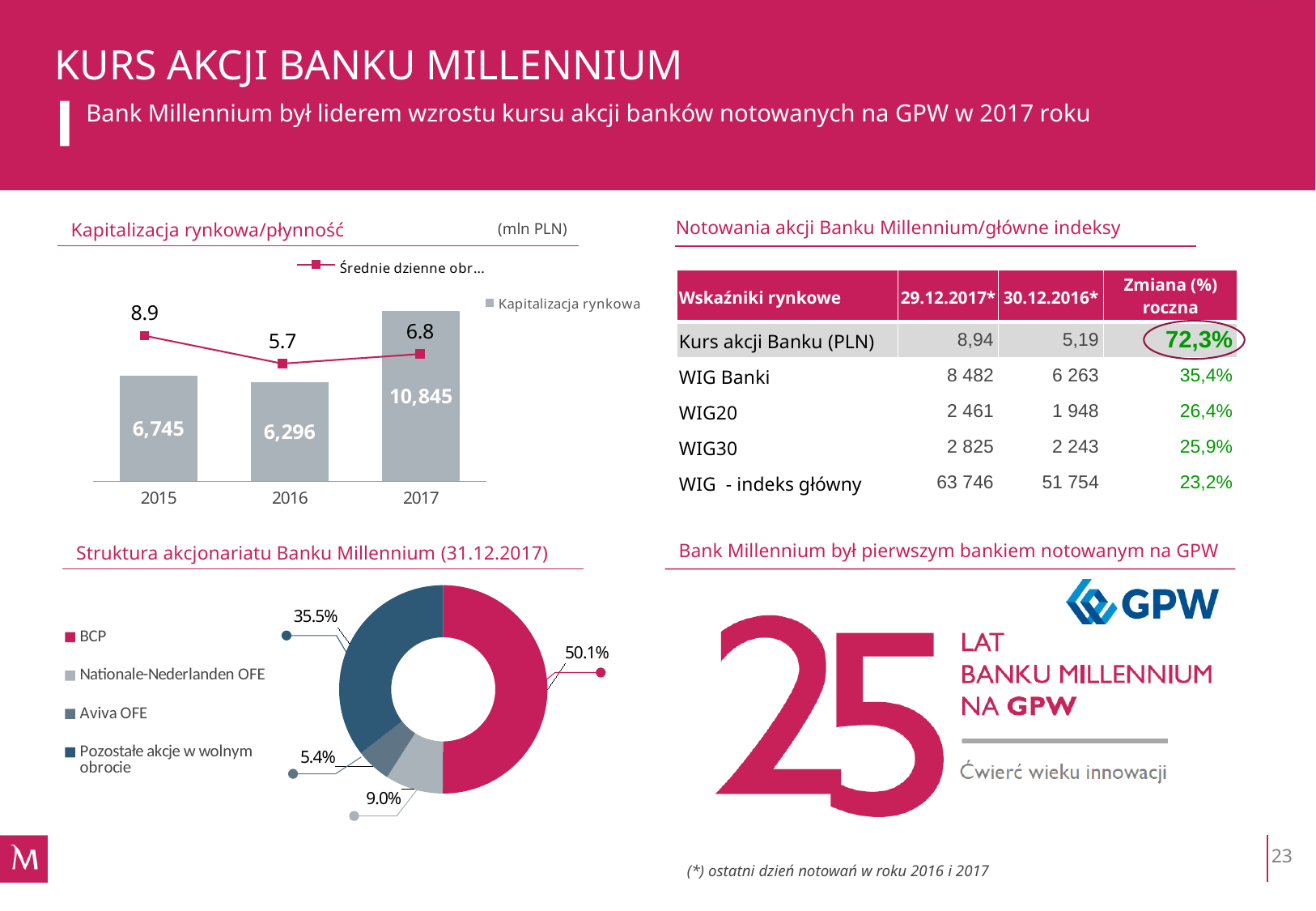
In the 'Kapitalizacja rynkowa/płynność' chart, what is the difference between the market capitalisation bars for 2017 and 2016? 4,549 In the 'Kapitalizacja rynkowa/płynność' chart, how many series does the legend list? 2 In the 'Kapitalizacja rynkowa/płynność' chart, what is the market capitalisation (Kapitalizacja rynkowa) value for 2017? 10,845 In the 'Struktura akcjonariatu Banku Millennium (31.12.2017)' chart, what share is held by Aviva OFE? 5.4% What type of chart is 'Struktura akcjonariatu Banku Millennium (31.12.2017)'? Donut (pie) chart In the 'Kapitalizacja rynkowa/płynność' chart, which year has the lowest value on the line series? 2016 In the 'Struktura akcjonariatu Banku Millennium (31.12.2017)' chart, which is larger: the share of Nationale-Nederlanden OFE or the share of Aviva OFE? Nationale-Nederlanden OFE In the 'Kapitalizacja rynkowa/płynność' chart, what is the market capitalisation value for 2016? 6,296 In the 'Kapitalizacja rynkowa/płynność' chart, which year has the highest market capitalisation bar? 2017 In the 'Struktura akcjonariatu Banku Millennium (31.12.2017)' chart, what share does BCP hold? 50.1% In the 'Kapitalizacja rynkowa/płynność' chart, what is the line value (Średnie dzienne obr...) for 2015? 8.9 In the 'Kapitalizacja rynkowa/płynność' chart, how many years are shown on the x axis? 3